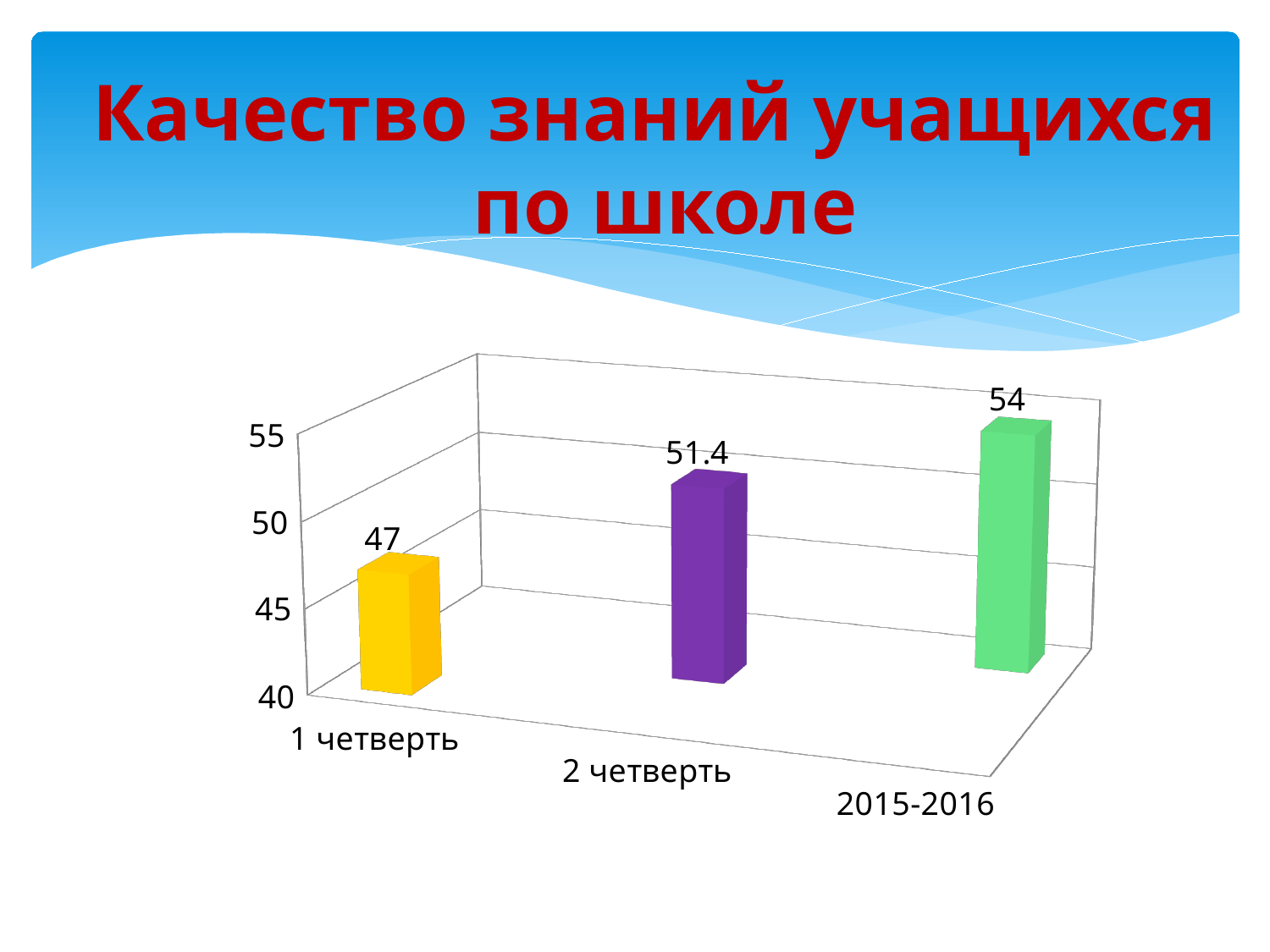
Which category has the lowest value? 1 четверть What is the difference between the values for 2015-2016 and 1 четверть? 7 Which category has the highest value? 2015-2016 Which is larger, the value for 2 четверть or the value for 1 четверть? 2 четверть What is the difference between the values for 2 четверть and 1 четверть? 4.4 Do the values rise or fall from 1 четверть to 2015-2016? rise What kind of chart is shown on the slide? bar chart How many categories are shown on the chart? 3 What is the value for 1 четверть? 47 What is the value for 2 четверть? 51.4 Is the value for 2 четверть greater or less than 50? greater What is the value for 2015-2016? 54